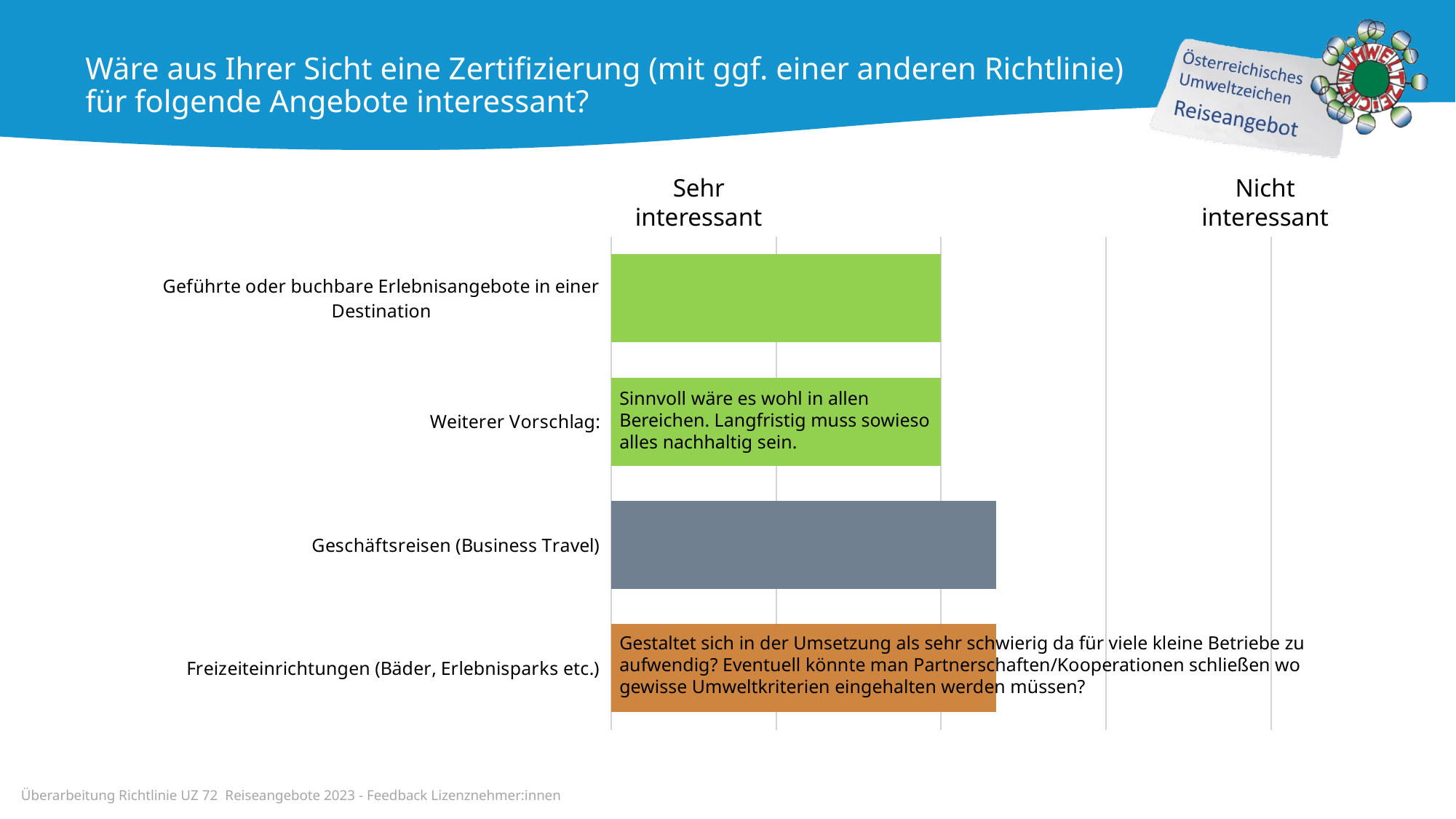
What colour is the bar for Geschäftsreisen (Business Travel)? grey Which bar is longer: Geschäftsreisen (Business Travel) or Geführte oder buchbare Erlebnisangebote in einer Destination? Geschäftsreisen (Business Travel) How many categories (offers) are plotted in the chart? 4 What kind of chart is shown on the slide? bar chart Which bar is longer: Freizeiteinrichtungen (Bäder, Erlebnisparks etc.) or Weiterer Vorschlag? Freizeiteinrichtungen (Bäder, Erlebnisparks etc.) What label appears at the left end of the chart's scale? Sehr interessant Which bar is shorter: Weiterer Vorschlag or Geschäftsreisen (Business Travel)? Weiterer Vorschlag